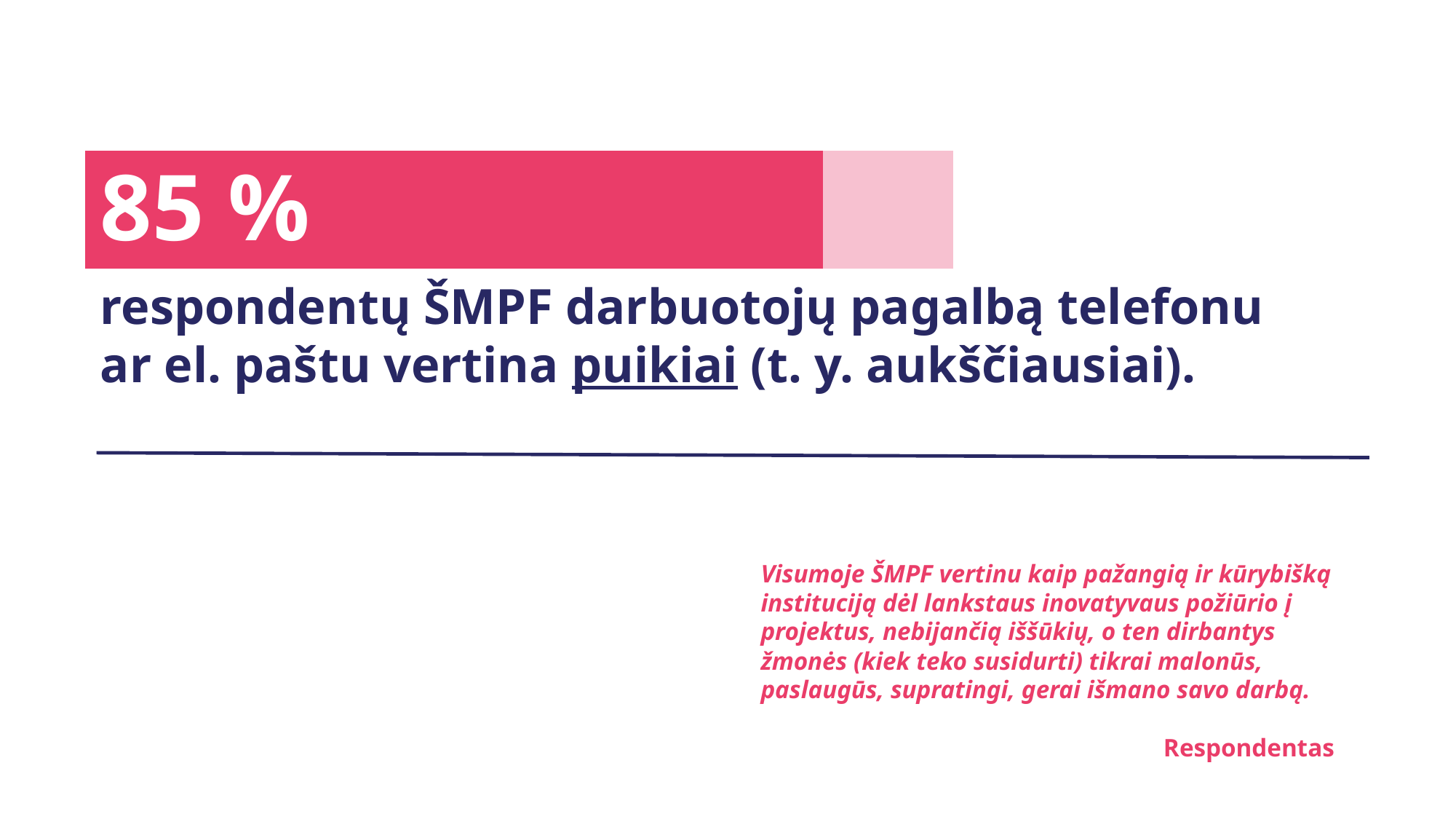
Does the filled portion of the bar cover more or less than half of its total length? more What colour is the filled portion of the bar? dark pink How many bars are shown on the slide? 1 What kind of chart is shown on the slide? bar chart What percentage of respondents rate ŠMPF staff help by phone or email as excellent, according to the bar on the slide? 85 % Is the value shown by the filled bar greater or less than 50 %? greater What rating does the 85 % bar refer to, according to the text below it? puikiai (excellent)